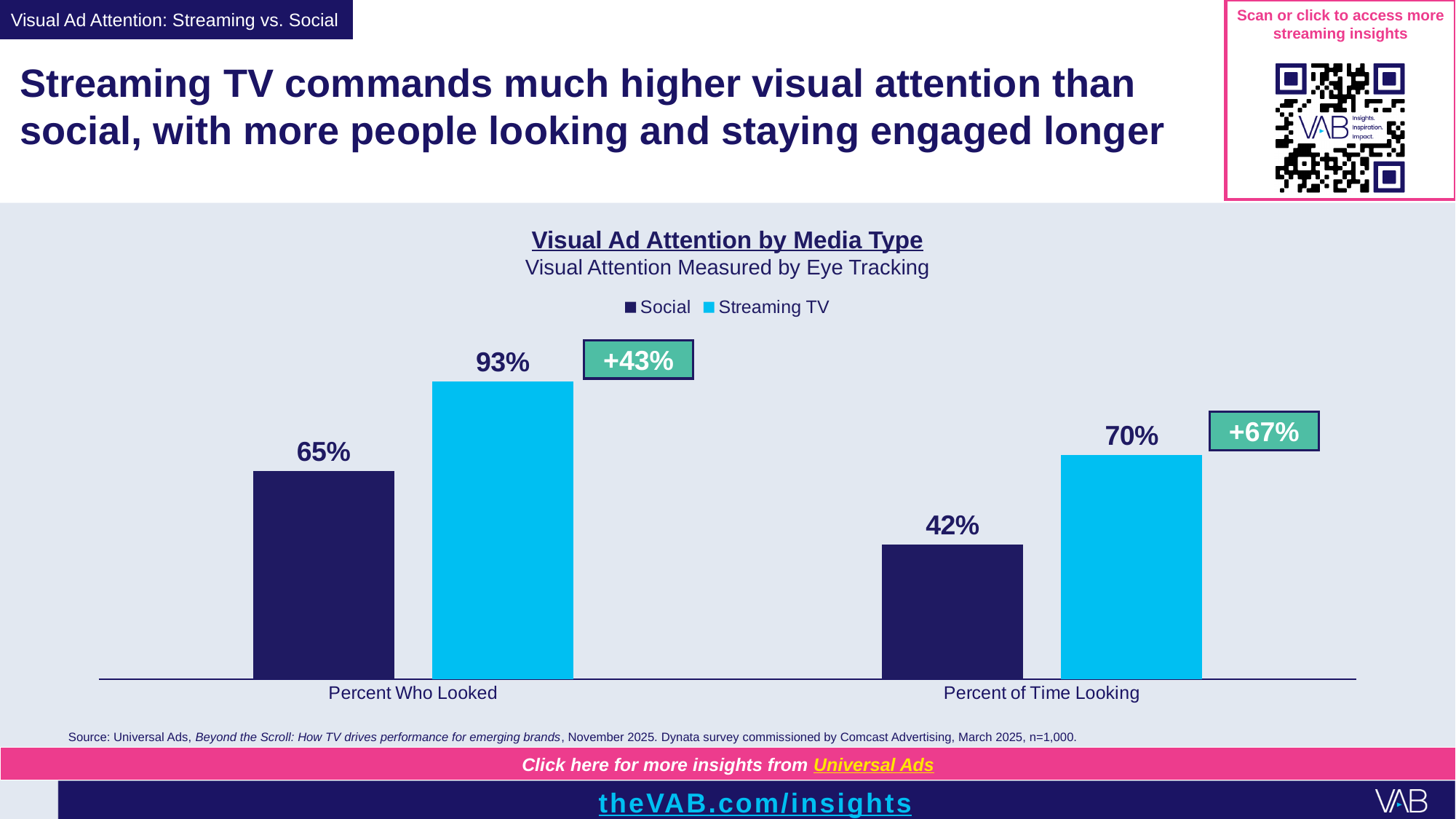
Which is larger: Social in Percent Who Looked or Streaming TV in Percent of Time Looking? Streaming TV in Percent of Time Looking How many series does the legend list? 2 What is the value for Streaming TV in the Percent of Time Looking category? 70% What kind of chart is shown on the slide? Bar chart What is the difference between Streaming TV and Social in the Percent Who Looked category? 28% What is the value for Streaming TV in the Percent Who Looked category? 93% What is the difference between Streaming TV and Social in the Percent of Time Looking category? 28% How many categories are shown on the x axis? 2 What is the value for Social in the Percent of Time Looking category? 42% Which series has the highest value in the Percent Who Looked category? Streaming TV Which bar has the lowest value on the chart? Social, Percent of Time Looking What is the value for Social in the Percent Who Looked category? 65%